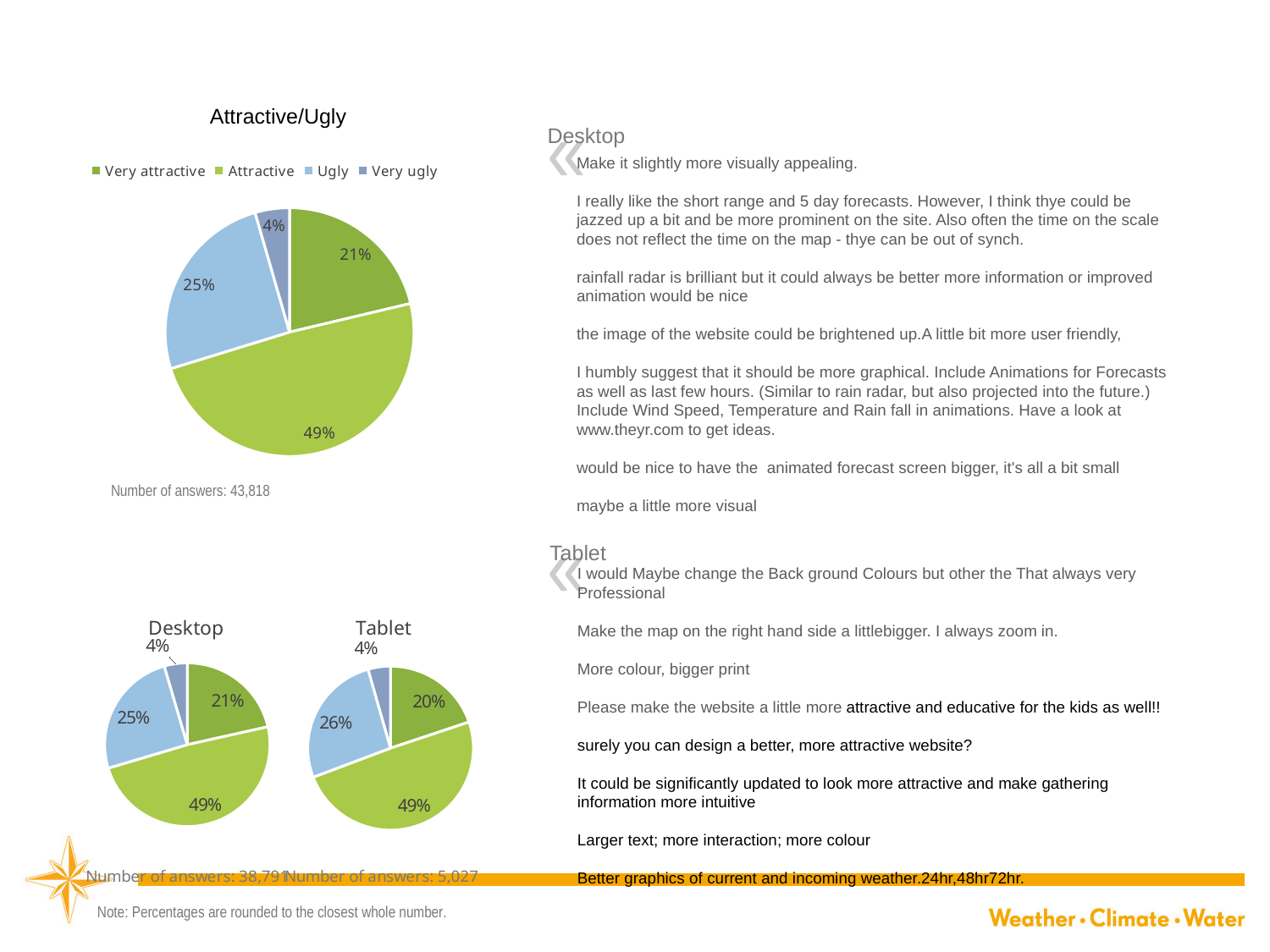
In the Tablet pie chart, what percentage of answers were 'Ugly'? 26% Which is larger: the 'Ugly' share in the Desktop pie chart or the 'Ugly' share in the Tablet pie chart? Tablet In the Desktop pie chart, what percentage of answers were 'Very ugly'? 4% In the Attractive/Ugly pie chart, what is the difference between the 'Attractive' and 'Very attractive' shares? 28% In the Attractive/Ugly pie chart, which category has the smallest share? Very ugly In the Tablet pie chart, what percentage of answers were 'Very attractive'? 20% In the Attractive/Ugly pie chart, what percentage of answers were 'Attractive'? 49% In the Attractive/Ugly pie chart, which category has the largest share? Attractive What kind of chart is the Attractive/Ugly chart? Pie chart How many answers does the Attractive/Ugly chart state it is based on? 43,818 In the Attractive/Ugly pie chart, what percentage of answers were 'Ugly'? 25% How many categories does the legend of the Attractive/Ugly chart list? 4